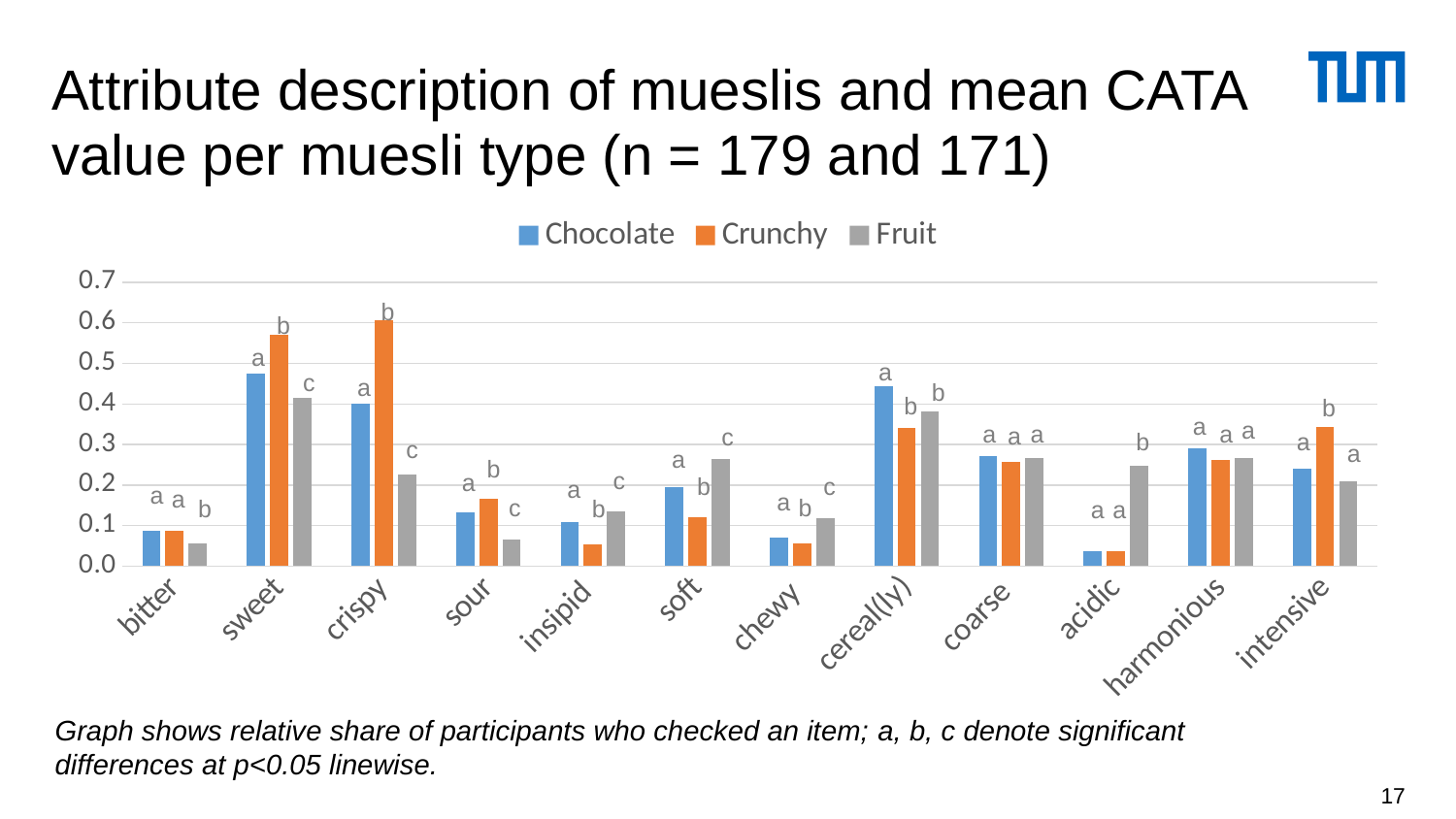
Which is larger for sweet: the Chocolate value or the Fruit value? Chocolate Which muesli type has the highest value for cereal(ly)? Chocolate How many series does the legend list? 3 Which muesli type has the highest value for acidic? Fruit Is the Chocolate value for acidic greater or less than 0.1? less Is the Crunchy value for sweet greater or less than 0.5? greater How many attribute categories are shown on the x axis? 12 Which muesli type has the highest value for soft? Fruit Which series is shown in orange in the legend? Crunchy What kind of chart is shown on the slide? bar chart